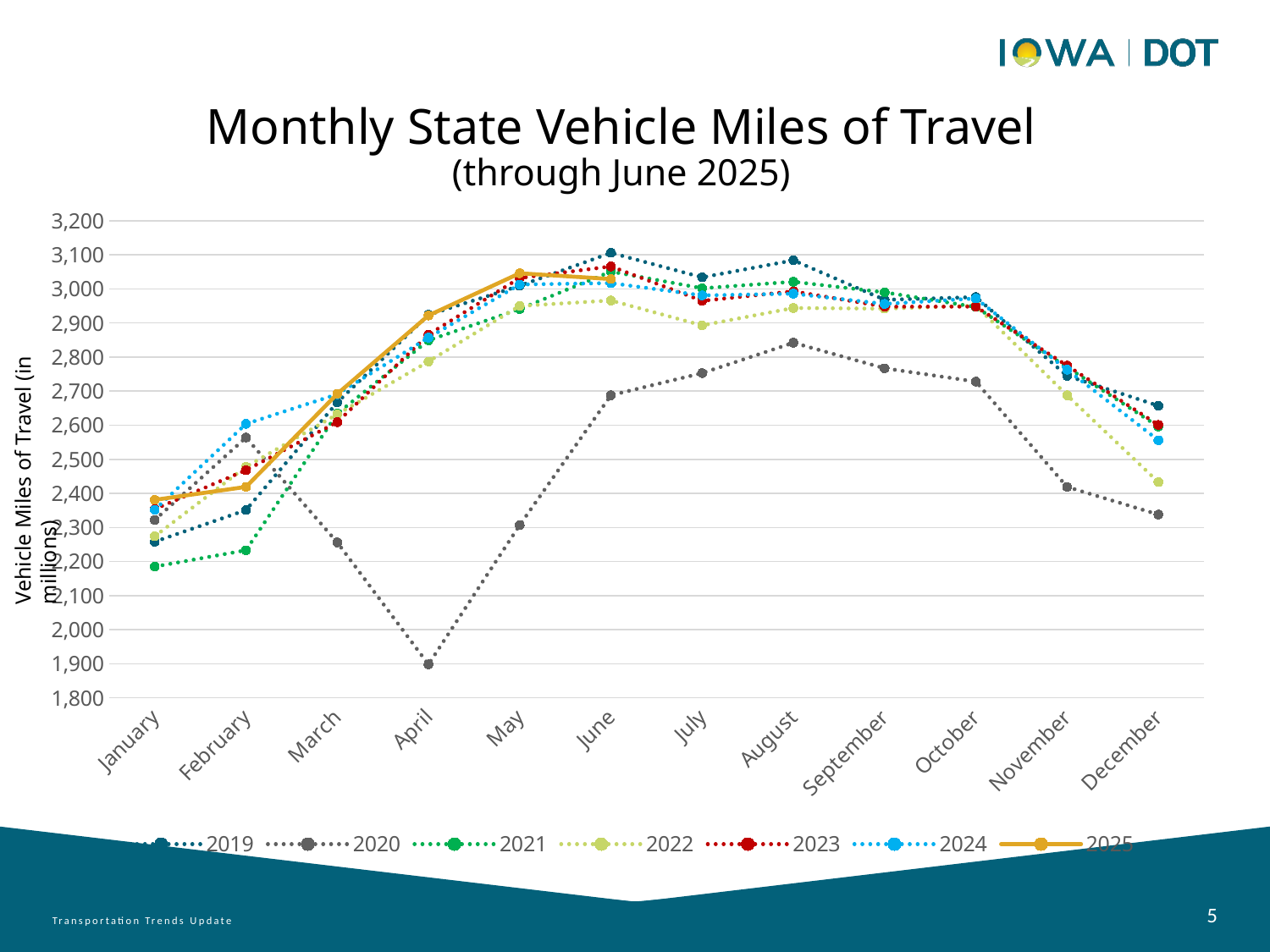
Which year's series has the lowest value in April? 2020 Is the value for 2020 in April greater or less than 2,000? less What kind of chart is shown on the slide? line chart Through which month does the 2025 series have data points? June Is the value for 2025 in May greater or less than 3,000? greater Is the value for 2020 in December greater or less than 2,400? less Does the 2025 series rise or fall from January to May? rise How many series does the legend list? 7 What is the title of the chart? Monthly State Vehicle Miles of Travel (through June 2025) How many months are shown along the x axis? 12 Which is larger in April, the value for 2019 or the value for 2020? 2019